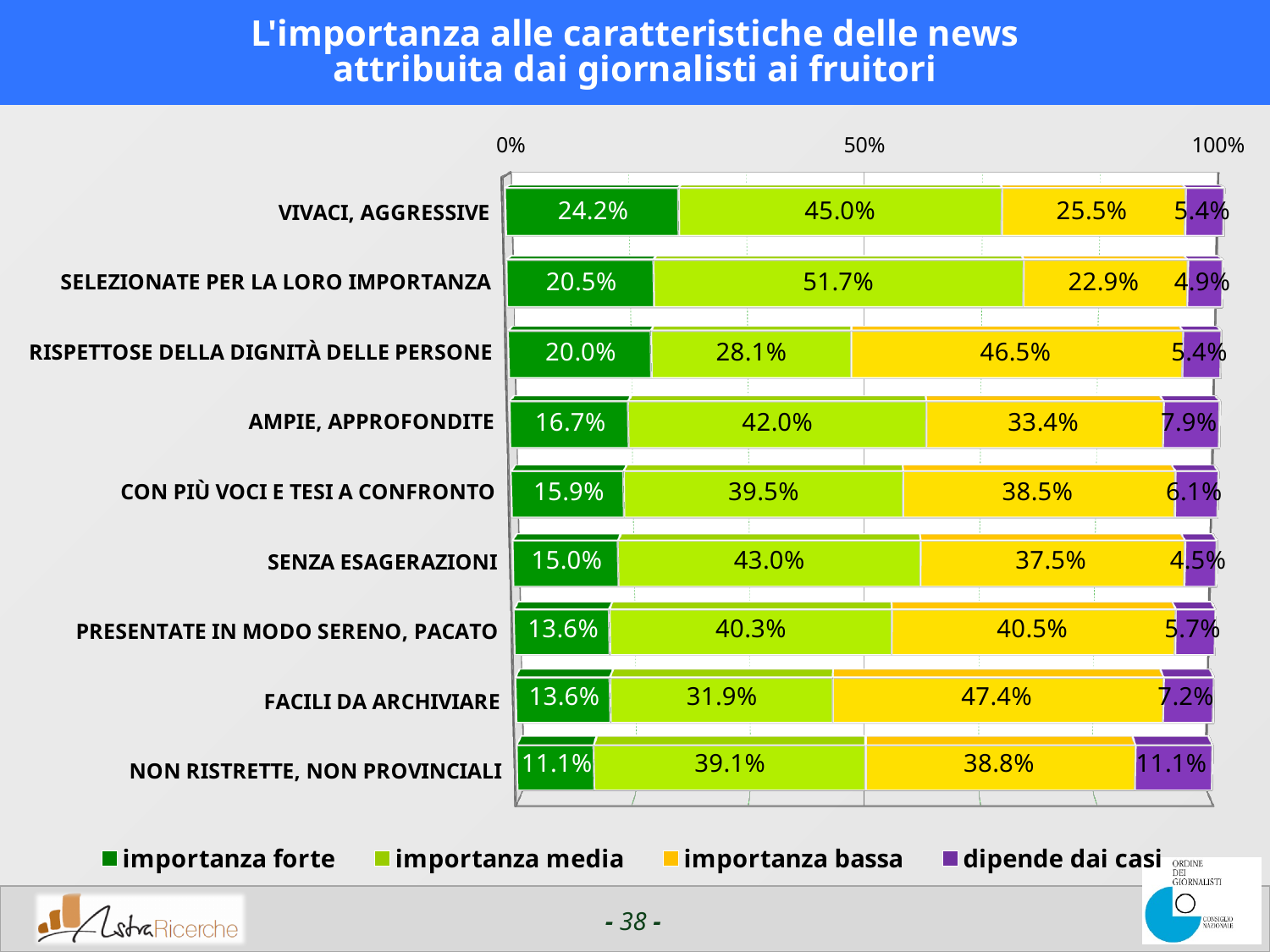
What is the difference in 'importanza forte' between VIVACI, AGGRESSIVE and NON RISTRETTE, NON PROVINCIALI? 13.1 percentage points What is the 'importanza media' value for SELEZIONATE PER LA LORO IMPORTANZA? 51.7% For RISPETTOSE DELLA DIGNITÀ DELLE PERSONE, which is larger: 'importanza media' or 'importanza bassa'? importanza bassa What is the 'importanza bassa' value for FACILI DA ARCHIVIARE? 47.4% Which category has the highest 'importanza media' value? SELEZIONATE PER LA LORO IMPORTANZA Which category has the lowest 'importanza forte' value? NON RISTRETTE, NON PROVINCIALI How many series does the legend list? 4 How many categories are shown in the chart? 9 What is the 'dipende dai casi' value for NON RISTRETTE, NON PROVINCIALI? 11.1% What kind of chart is shown on the slide? Stacked bar chart Which category has the highest 'importanza forte' value? VIVACI, AGGRESSIVE What is the 'importanza forte' value for VIVACI, AGGRESSIVE? 24.2%